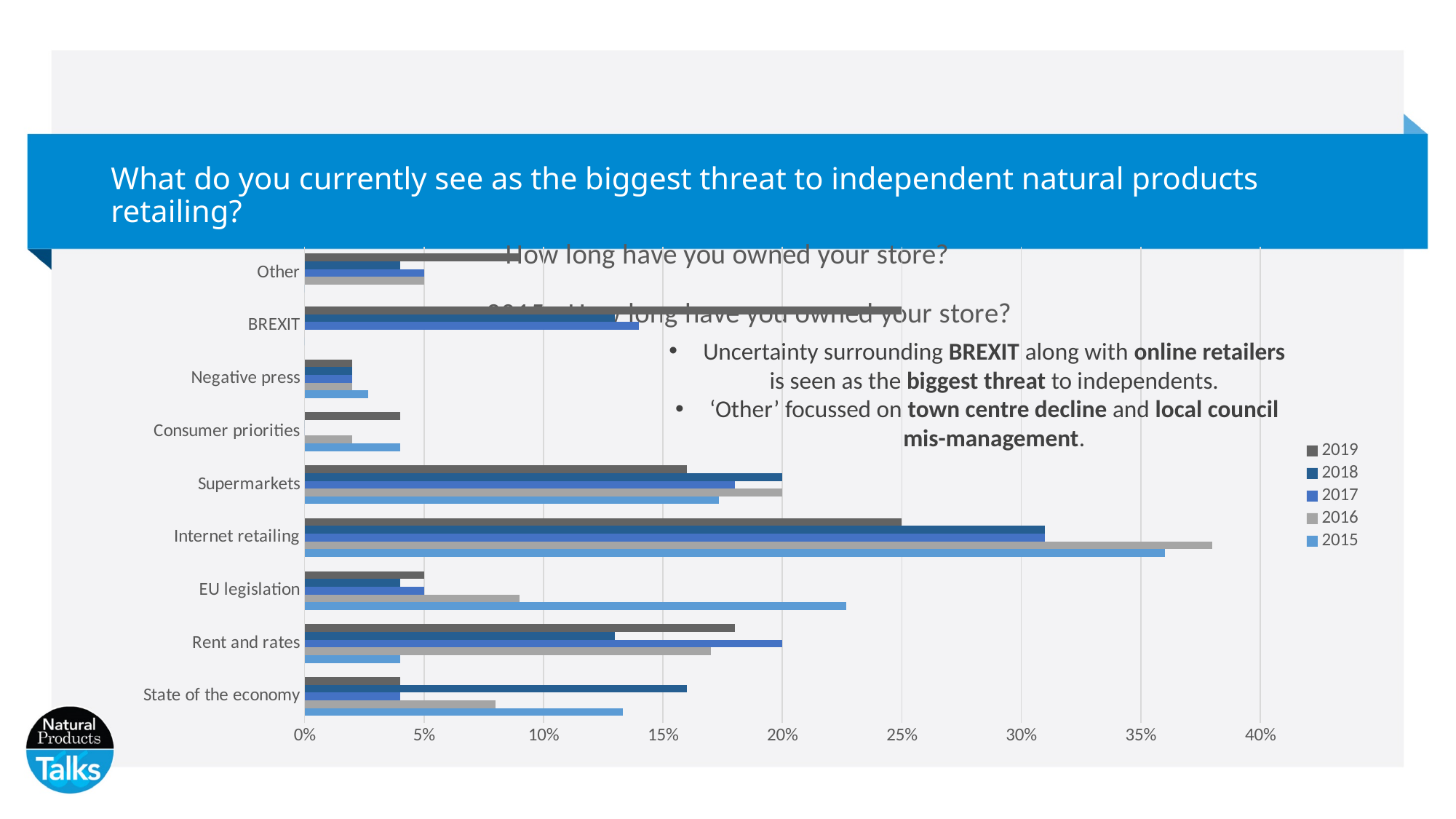
How many threat categories are plotted on the chart? 9 Is the 2019 value for Supermarkets greater or less than 15%? greater How many series does the chart legend list? 5 Is the 2016 value for Internet retailing greater or less than 35%? greater Is the 2019 value for BREXIT greater or less than 20%? greater For Rent and rates, which is larger: the 2017 value or the 2015 value? 2017 What kind of chart is shown on the slide? bar chart Which category has the highest value for the 2016 series? Internet retailing For State of the economy, which is larger: the 2018 value or the 2019 value? 2018 What are the entries listed in the chart legend? 2019, 2018, 2017, 2016, 2015 Which category has the highest value for the 2015 series? Internet retailing